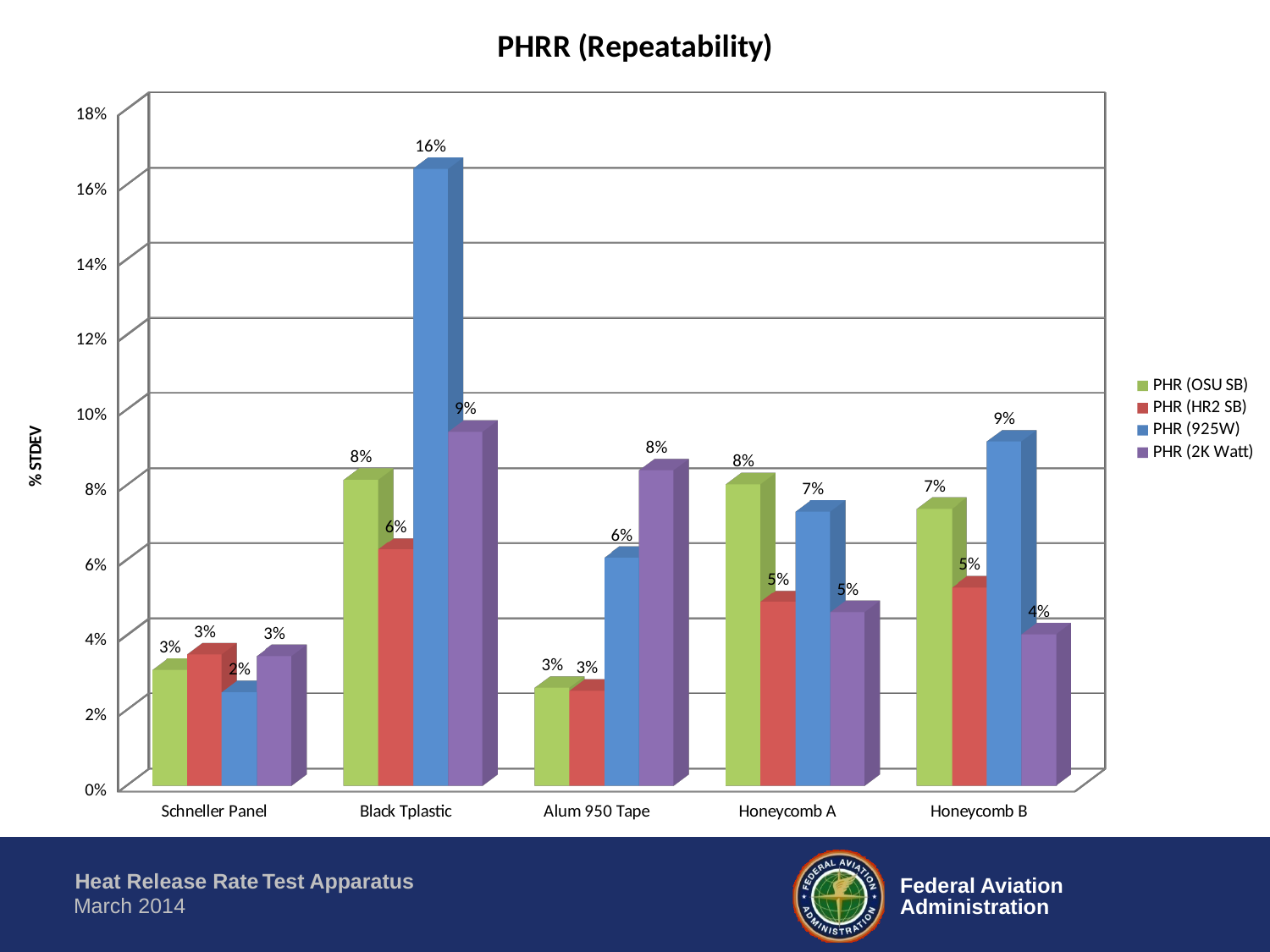
What is the value for PHR (925W) for Black Tplastic? 16% How many categories are shown on the x axis? 5 What is the value for PHR (HR2 SB) for Honeycomb B? 5% What is the title of the chart? PHRR (Repeatability) What kind of chart is shown on the slide? Bar chart How many series does the legend list? 4 For Honeycomb B, which is larger: PHR (925W) or PHR (2K Watt)? PHR (925W) What is the difference between the PHR (925W) value and the PHR (HR2 SB) value for Black Tplastic? 10% Which category has the lowest value for PHR (925W)? Schneller Panel What is the value for PHR (2K Watt) for Alum 950 Tape? 8% What is the value for PHR (OSU SB) for Honeycomb A? 8% Which category has the highest value for PHR (925W)? Black Tplastic